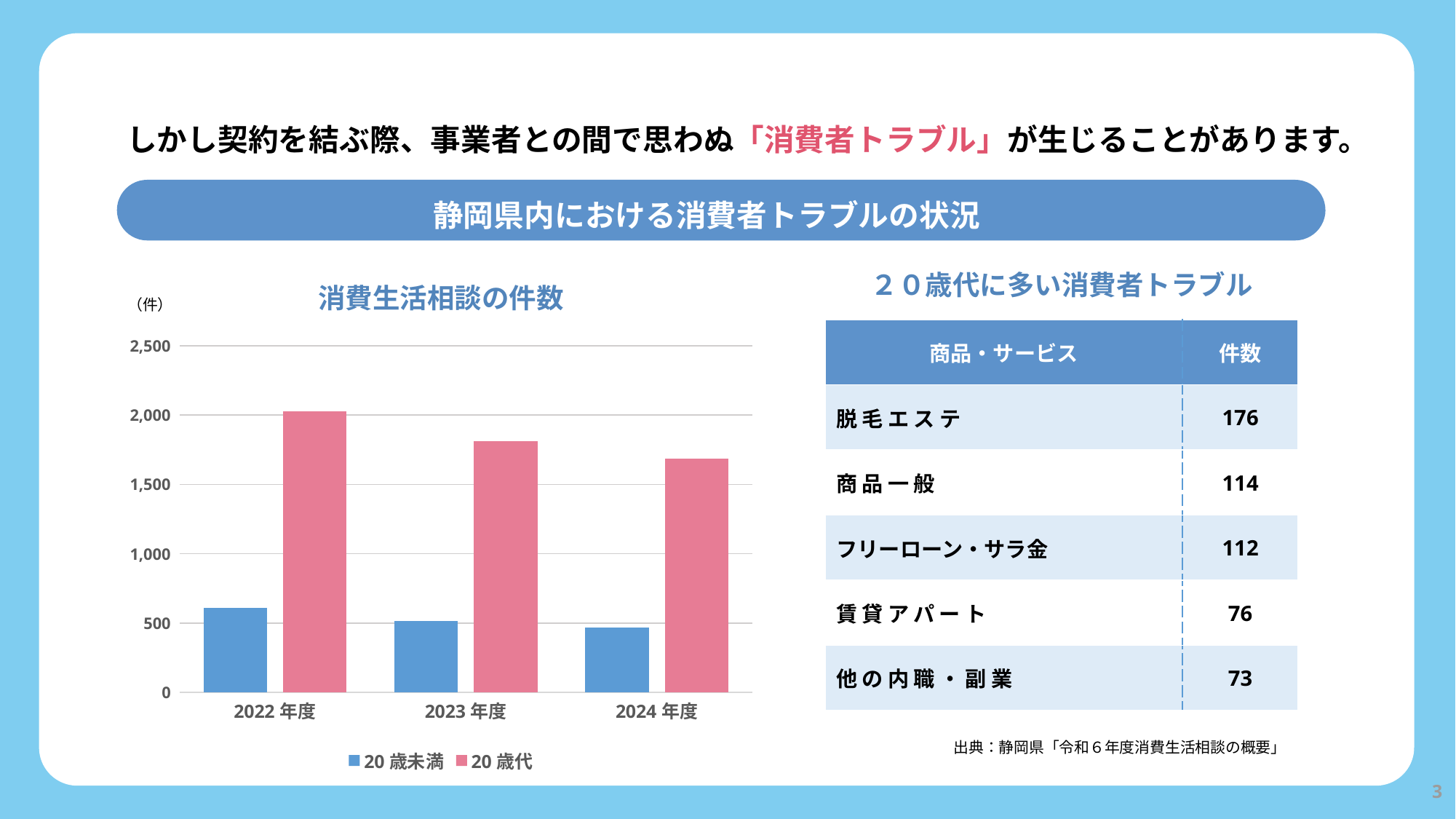
Is the value for 20歳代 in 2024年度 greater or less than 1,500? greater Which series is shown in pink in the chart? 20歳代 In 2022年度, which is larger: the value for 20歳未満 or for 20歳代? 20歳代 Is the value for 20歳未満 in 2022年度 greater or less than 500? greater What kind of chart is shown on the slide? bar chart How many fiscal years are shown on the x axis of the chart? 3 In which fiscal year is the 20歳代 bar the highest? 2022年度 In which fiscal year is the 20歳未満 bar the lowest? 2024年度 How many series does the chart's legend list? 2 What is the title of the chart on the slide? 消費生活相談の件数 Do the values for 20歳代 rise or fall from 2022年度 to 2024年度? fall